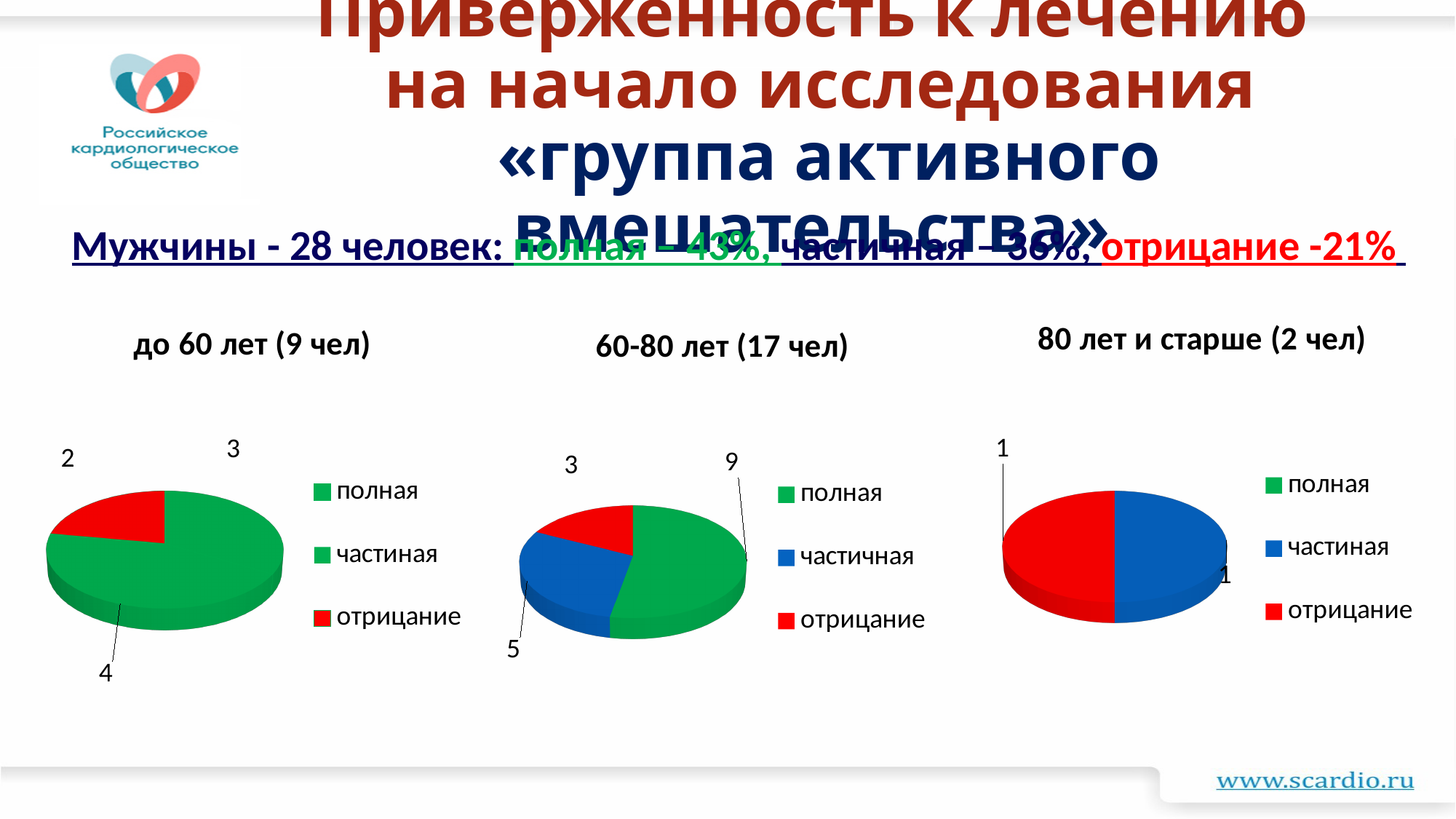
In the "60-80 лет (17 чел)" chart, what is the value for отрицание? 3 In the "60-80 лет (17 чел)" chart, what is the difference between the values for полная and частичная? 4 In the "60-80 лет (17 чел)" chart, which category has the smallest slice? отрицание In the "60-80 лет (17 чел)" chart, what is the value for частичная? 5 How many slices are visible in the "80 лет и старше (2 чел)" pie chart? 2 In the "60-80 лет (17 чел)" chart, which category has the largest slice? полная In the "до 60 лет (9 чел)" chart, what is the value for отрицание (the red slice)? 2 In the "60-80 лет (17 чел)" chart, which is larger: частичная or отрицание? частичная How many entries does the legend of the "60-80 лет (17 чел)" chart list? 3 In the "60-80 лет (17 чел)" chart, what is the value for полная? 9 In the "80 лет и старше (2 чел)" chart, what is the value for отрицание (the red slice)? 1 What kind of chart is used for the "60-80 лет (17 чел)" chart? pie chart